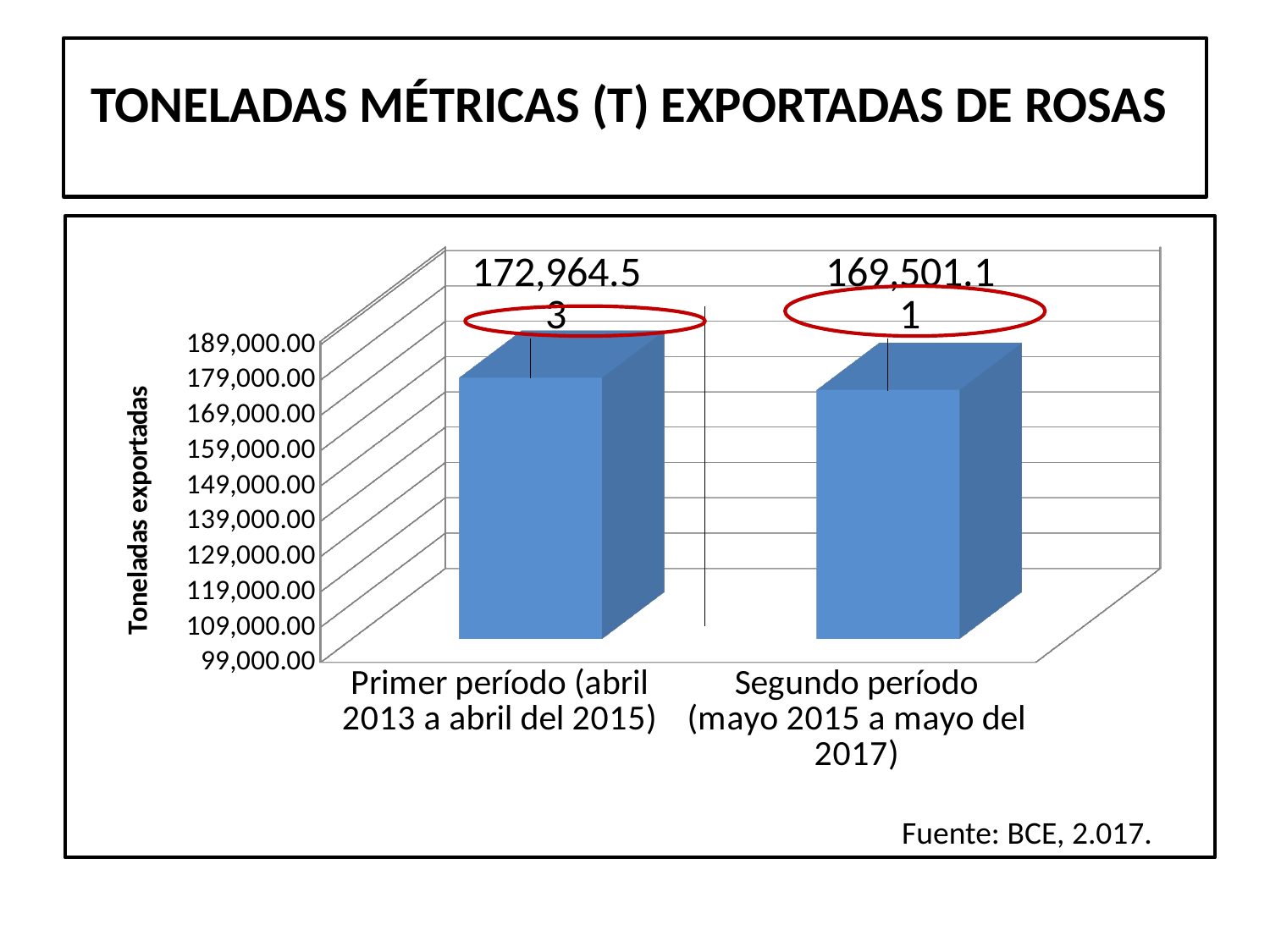
What is the value for Segundo período (mayo 2015 a mayo del 2017)? 169,501.11 Is the value for Primer período greater or less than 179,000.00? less Which period has the highest value of toneladas exportadas? Primer período (abril 2013 a abril del 2015) What is the value for Primer período (abril 2013 a abril del 2015)? 172,964.53 Is the value for Segundo período greater or less than 159,000.00? greater Do the values rise or fall from the first period to the second period? Fall What is the difference between the value for Primer período and the value for Segundo período? 3,463.42 What is the label of the vertical axis of the chart? Toneladas exportadas How many categories (periods) are shown in the chart? 2 Which is larger, the value for Primer período or the value for Segundo período? Primer período What kind of chart is shown on the slide? Bar chart Which period has the lowest value of toneladas exportadas? Segundo período (mayo 2015 a mayo del 2017)